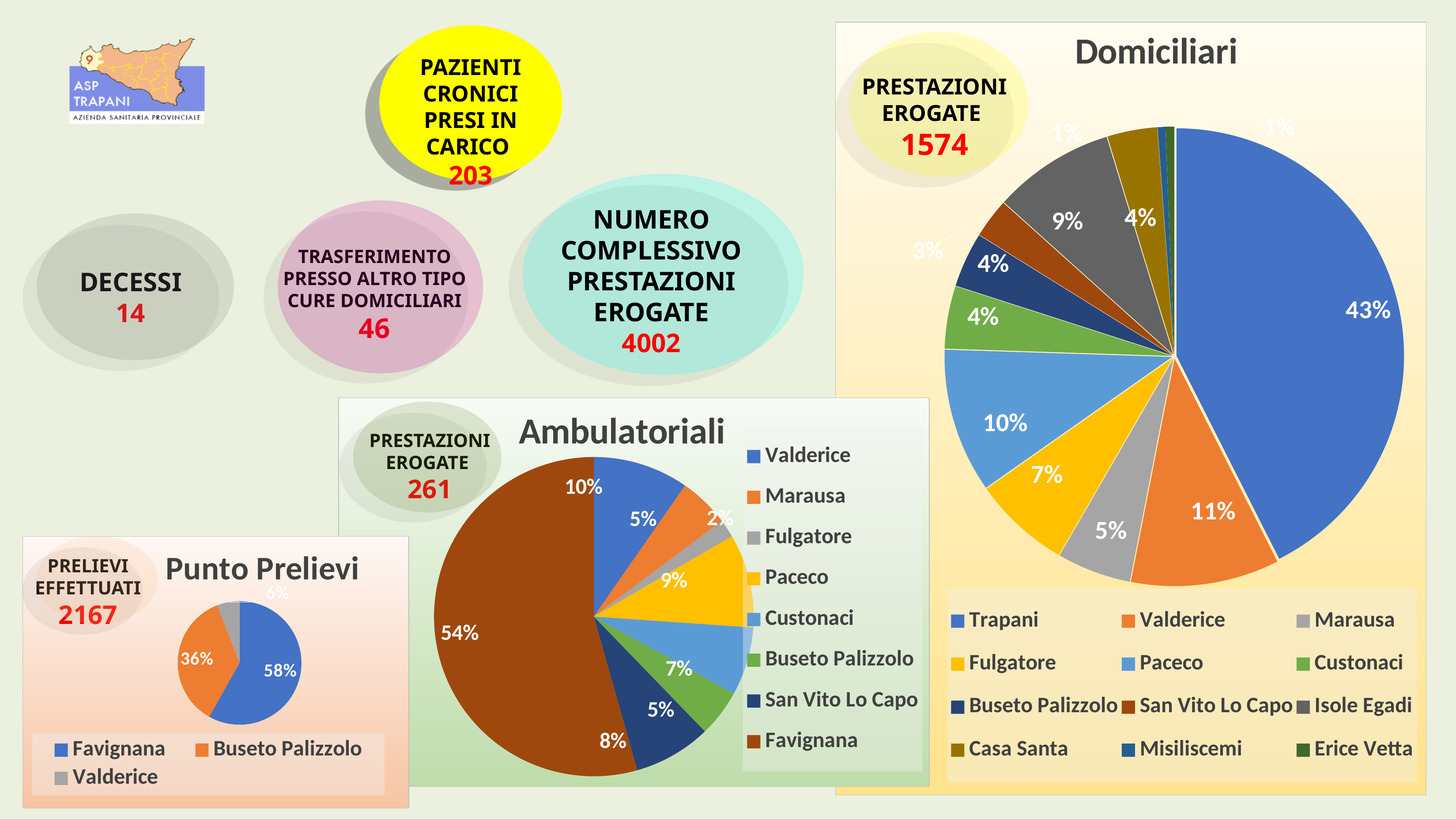
In the Domiciliari chart, which is larger, the share of Valderice or the share of Isole Egadi? Valderice In the Punto Prelievi chart, what share does Favignana have? 58% In the Domiciliari chart, which category has the largest slice? Trapani What kind of chart is the Domiciliari chart? Pie chart In the Ambulatoriali chart, what share does Favignana have? 54% In the Ambulatoriali chart, which category has the smallest slice? Fulgatore In the Domiciliari chart, what share does Paceco have? 10% In the Ambulatoriali chart, what is the difference between the shares of Valderice and Custonaci? 3% In the Punto Prelievi chart, which category has the smallest slice? Valderice How many categories does the Ambulatoriali chart's legend list? 8 How many categories does the Punto Prelievi chart's legend list? 3 How many categories does the Domiciliari chart's legend list? 12